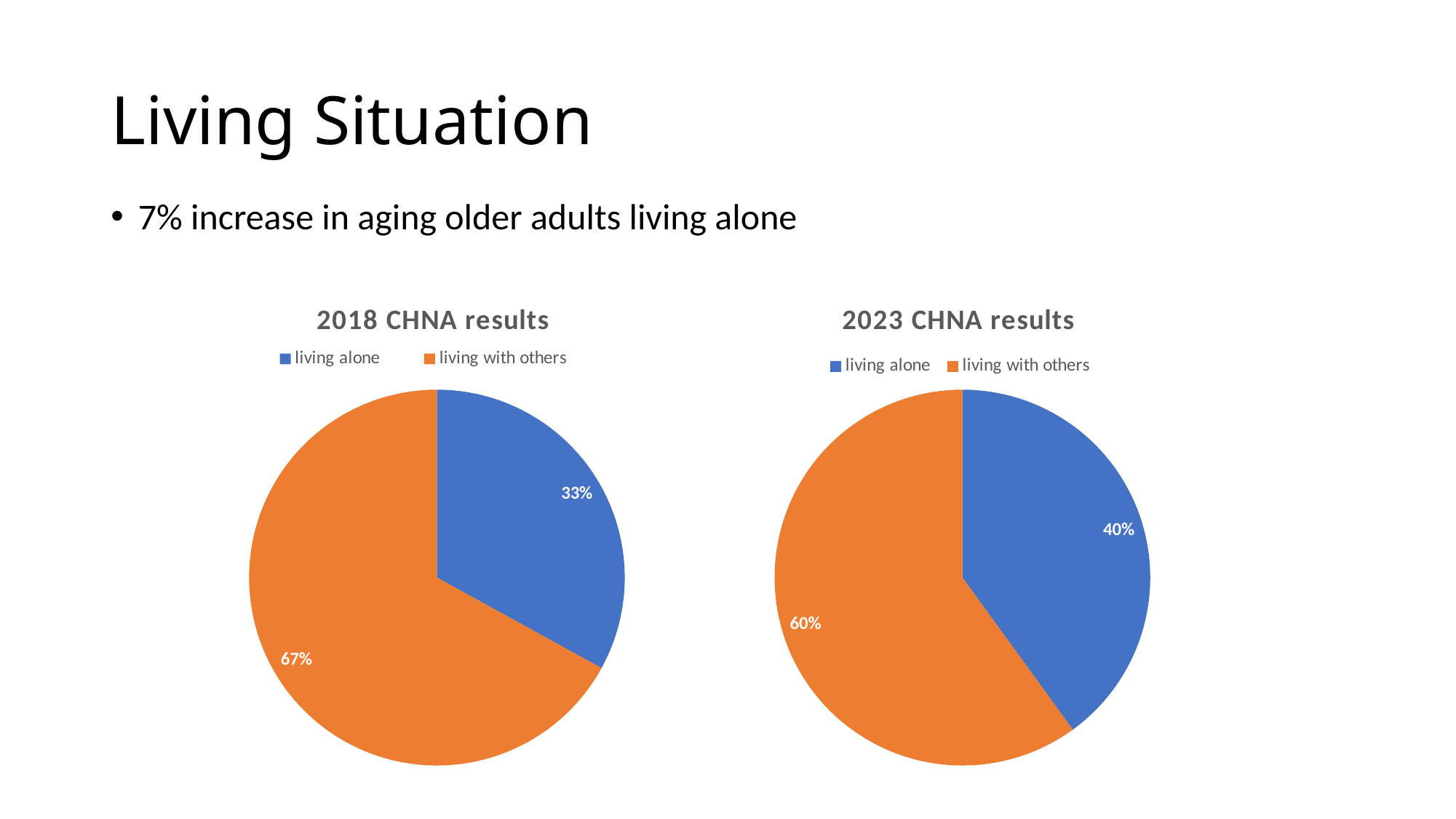
What kind of chart is the 2023 CHNA results chart? pie chart In the 2023 CHNA results chart, what colour is the 'living alone' slice? blue Is the 'living alone' share larger in the 2018 CHNA results chart or the 2023 CHNA results chart? 2023 CHNA results In the 2018 CHNA results chart, what share of the pie is 'living with others'? 67% In the 2023 CHNA results chart, what is the difference between the 'living with others' and 'living alone' shares? 20% In the 2018 CHNA results chart, what share of the pie is 'living alone'? 33% In the 2018 CHNA results chart, which category has the largest slice? living with others In the 2023 CHNA results chart, what share of the pie is 'living with others'? 60% In the 2018 CHNA results chart, what is the difference between the 'living with others' and 'living alone' shares? 34% In the 2023 CHNA results chart, which category has the smallest slice? living alone How many categories does the 2018 CHNA results chart show? 2